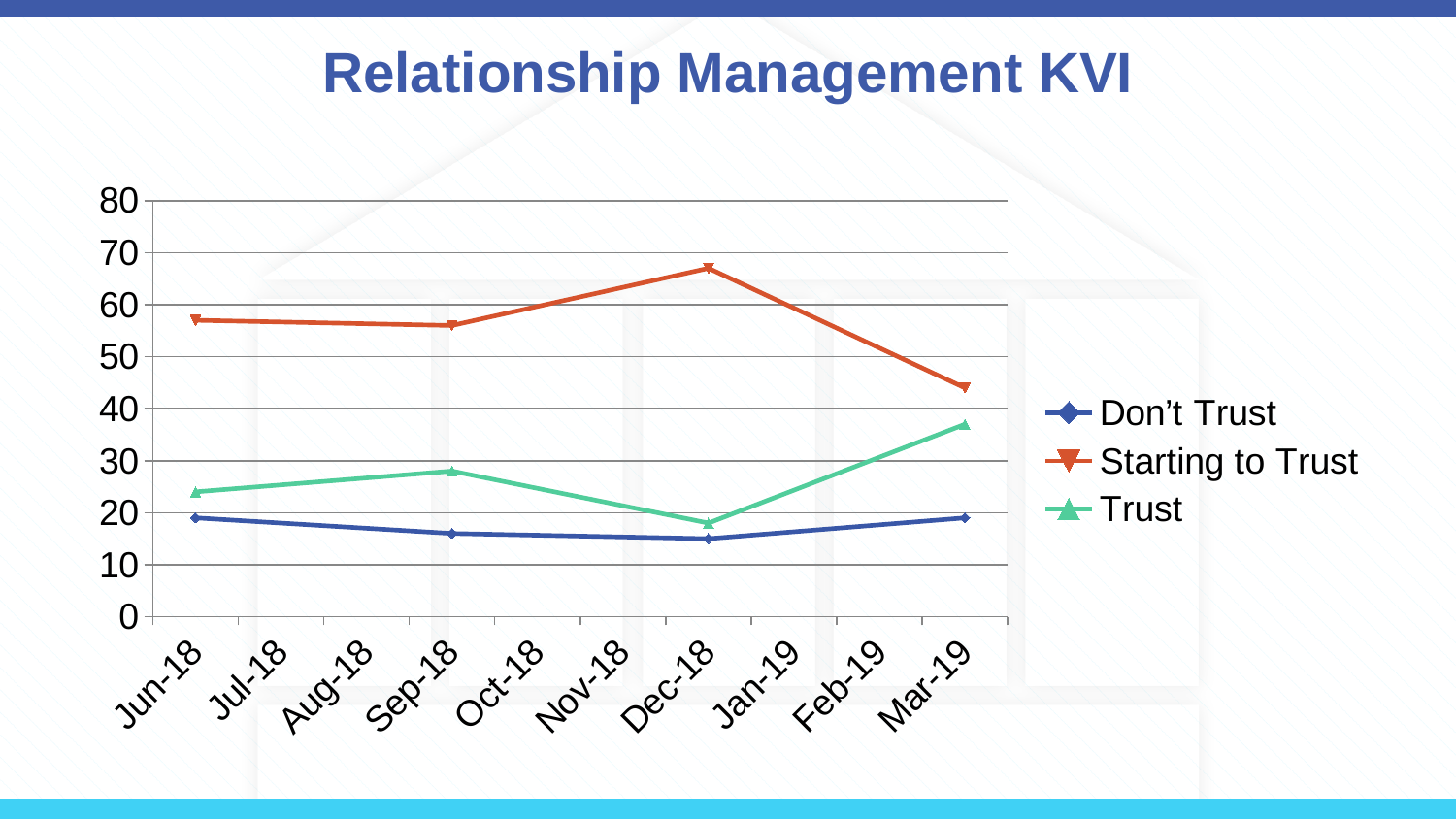
How many series does the legend list? 3 Which series has the highest value at Dec-18? Starting to Trust Is the value for Trust at Mar-19 greater or less than 30? greater Is the value for Starting to Trust at Mar-19 greater or less than 50? less Does the Starting to Trust series rise or fall between Dec-18 and Mar-19? fall What kind of chart is shown on the slide? line chart Is the value for Starting to Trust at Dec-18 greater or less than 60? greater How many month labels are shown on the x axis? 10 At which month does the Starting to Trust series reach its lowest value? Mar-19 At Mar-19, which is larger: Trust or Don't Trust? Trust What is the title of the chart? Relationship Management KVI What colour is the line for the Trust series? green